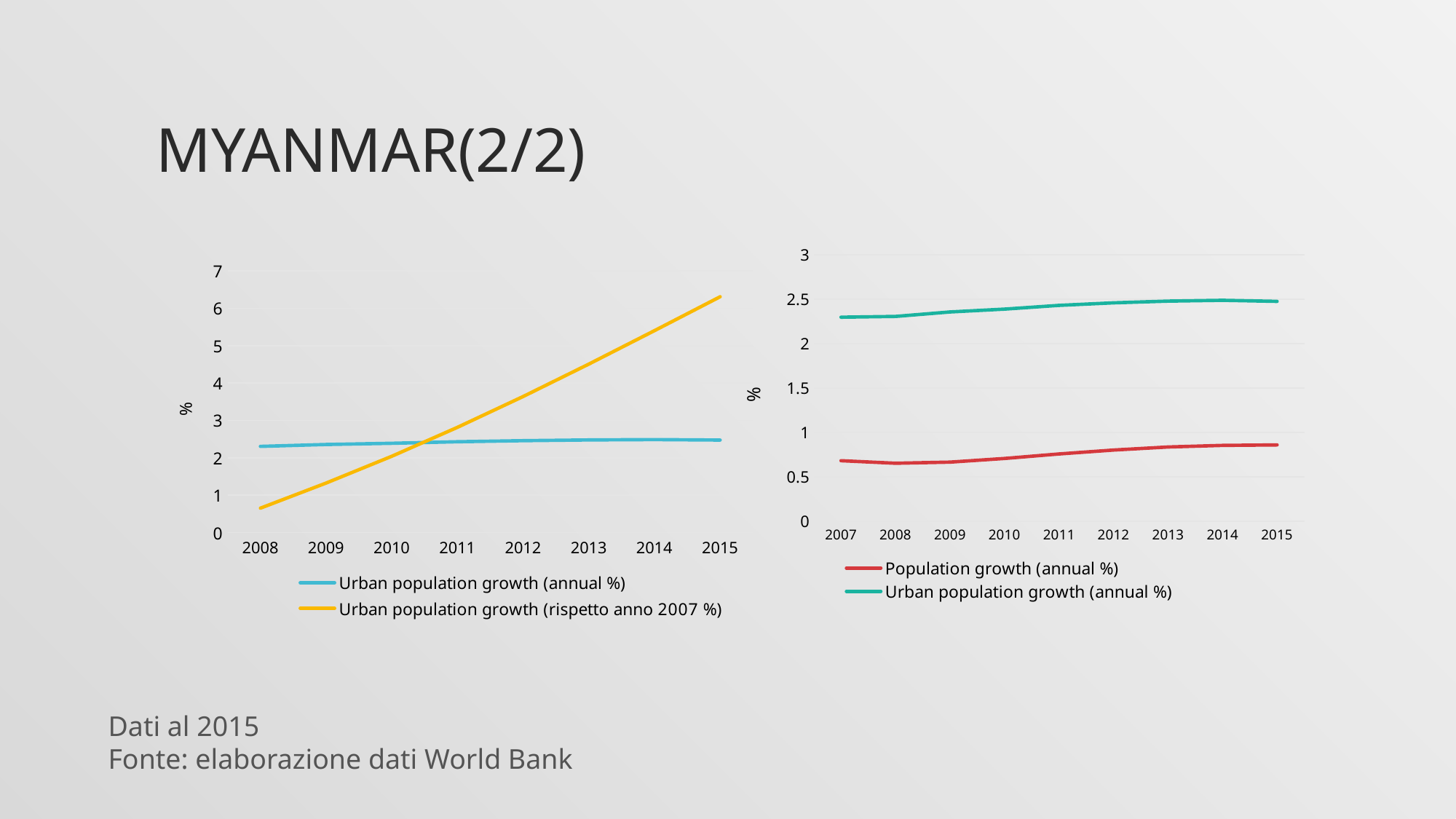
How many years are shown on the x axis of the right chart? 9 In the left chart, does the 'Urban population growth (rispetto anno 2007 %)' line rise or fall from 2008 to 2015? rise How many series does the legend of the left chart list? 2 In the left chart, which series has the higher value in 2015, 'Urban population growth (annual %)' or 'Urban population growth (rispetto anno 2007 %)'? Urban population growth (rispetto anno 2007 %) How many years are shown on the x axis of the left chart? 8 In the right chart, is the value of 'Population growth (annual %)' in 2015 greater or less than 1? less In the right chart, what colour is the 'Population growth (annual %)' line? red In the left chart, is the value of 'Urban population growth (rispetto anno 2007 %)' in 2015 greater or less than 5? greater In the right chart, which series has the higher value in 2015, 'Population growth (annual %)' or 'Urban population growth (annual %)'? Urban population growth (annual %) What kind of chart is the left chart on the slide? line chart In the left chart, is the value of 'Urban population growth (rispetto anno 2007 %)' in 2008 greater or less than 1? less How many series does the legend of the right chart list? 2